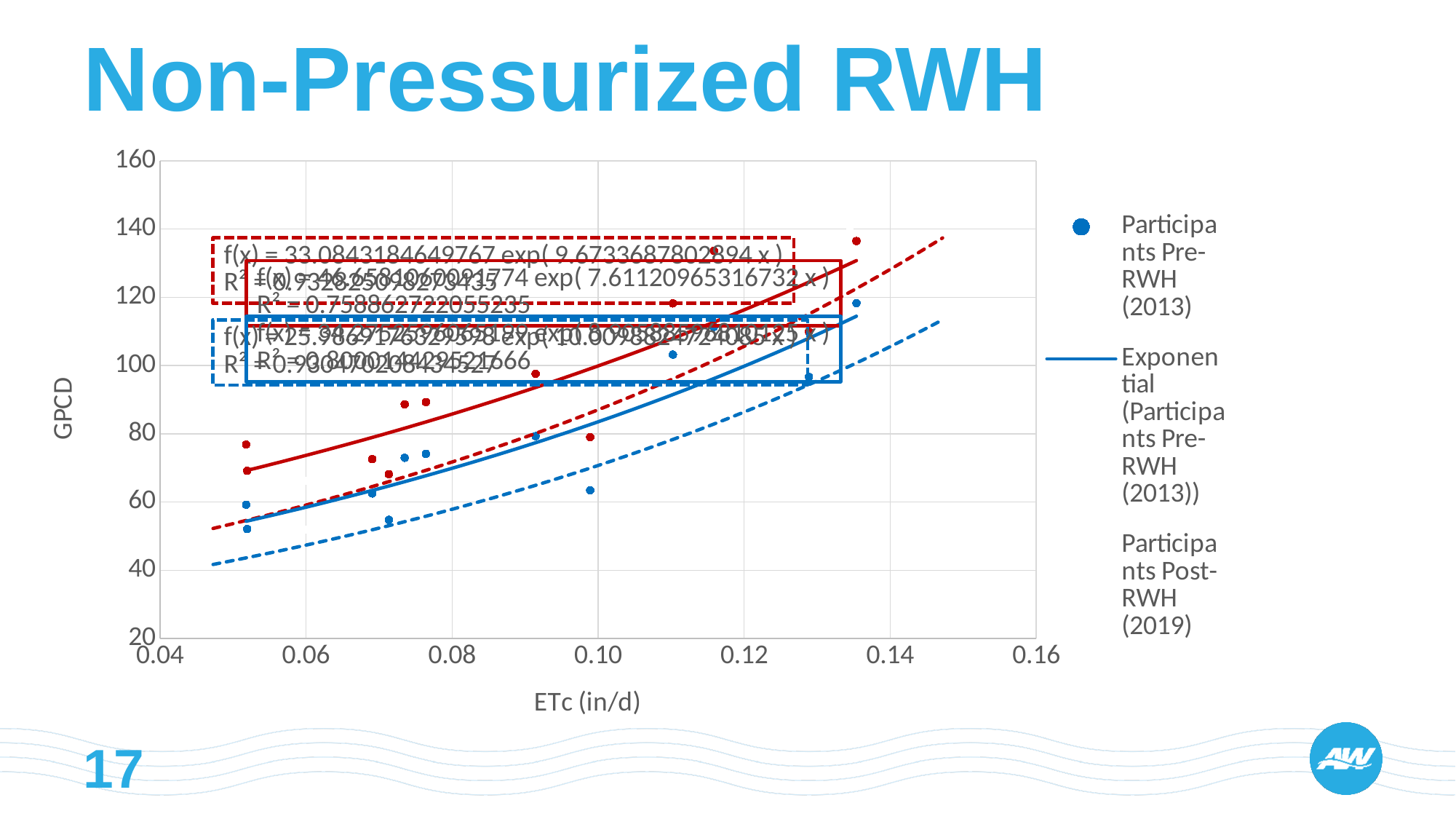
What is the title of the x axis of the chart? ETc (in/d) What is the title of the y axis of the chart? GPCD What kind of chart is shown on the slide? scatter chart Do the GPCD values generally rise or fall as ETc increases along the x axis? rise What is the maximum value shown on the y axis of the chart? 160